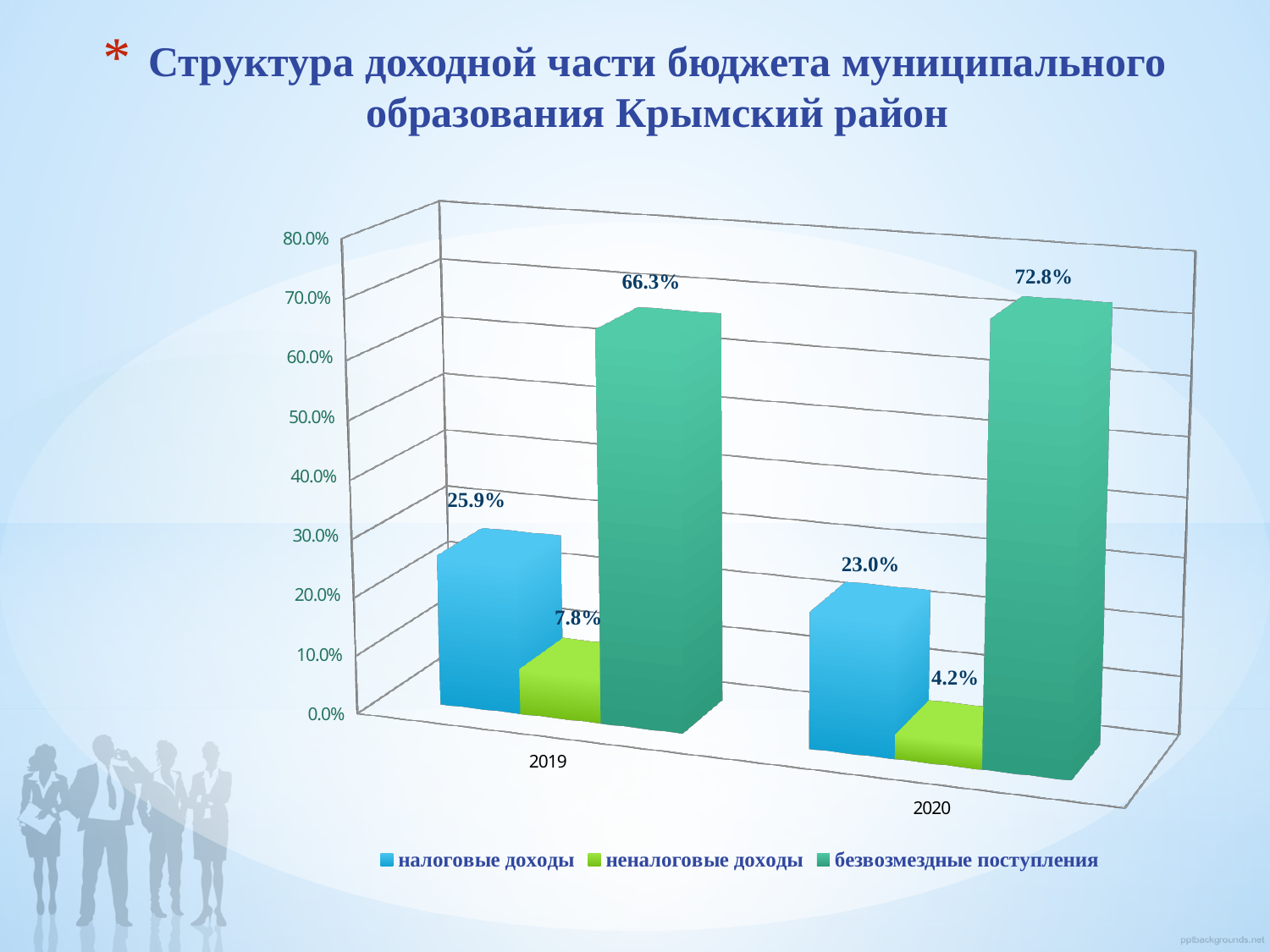
Which series has the highest value in 2019? безвозмездные поступления What is the difference between безвозмездные поступления in 2020 and in 2019? 6.5% How many categories are shown on the x axis? 2 How many series does the legend list? 3 What is the difference between налоговые доходы and неналоговые доходы in 2019? 18.1% Does the value for неналоговые доходы rise or fall from 2019 to 2020? fall What is the value for безвозмездные поступления in 2020? 72.8% What is the value for налоговые доходы in 2019? 25.9% What kind of chart is shown on the slide? bar chart Which series has the lowest value in 2020? неналоговые доходы Which is larger: налоговые доходы in 2019 or налоговые доходы in 2020? налоговые доходы in 2019 What is the value for неналоговые доходы in 2020? 4.2%